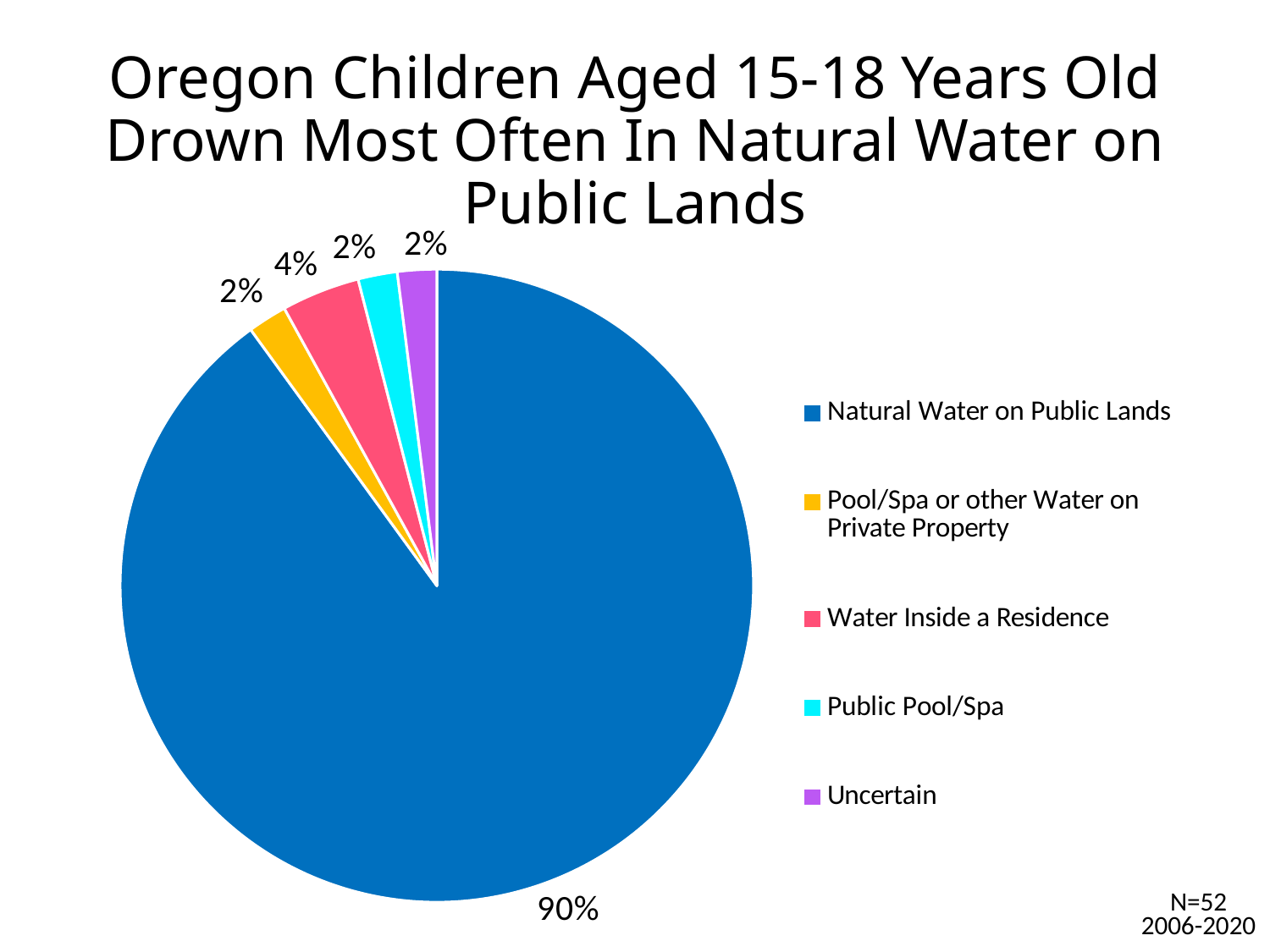
What share of the pie is Water Inside a Residence? 4% What kind of chart is shown on the slide? Pie chart What share of the pie is Natural Water on Public Lands? 90% What share of the pie is Public Pool/Spa? 2% What colour is the slice for Natural Water on Public Lands? Blue What is the sample size (N) noted on the slide? N=52 Which is larger, the share for Water Inside a Residence or the share for Uncertain? Water Inside a Residence What is the difference in percentage points between Natural Water on Public Lands and Water Inside a Residence? 86 Which category has the largest slice of the pie? Natural Water on Public Lands How many categories does the legend list? 5